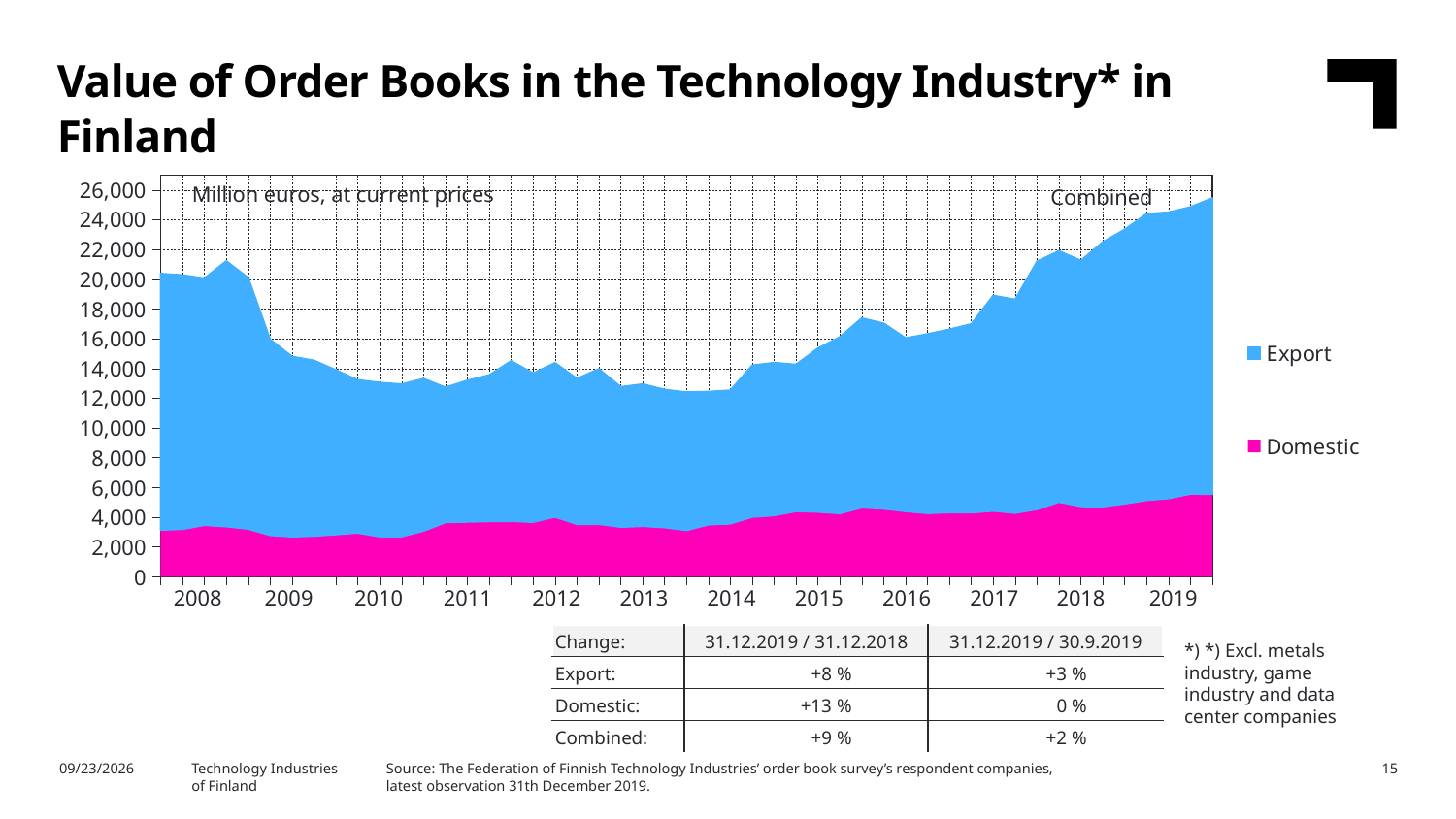
How many year labels are shown on the x axis? 12 Is the Domestic value in 2010 greater or less than 4,000? less What type of chart is shown on the slide? Area chart What unit is stated in the label at the top of the chart? Million euros, at current prices How many series does the chart legend list? 2 Which series has the larger values throughout the chart, Export or Domestic? Export Is the combined value of order books at the end of 2019 greater or less than 24,000? greater Does the combined value of order books rise or fall from 2017 to 2019? rise Is the combined value of order books in 2008 greater or less than 18,000? greater Which two series are listed in the chart legend? Export and Domestic